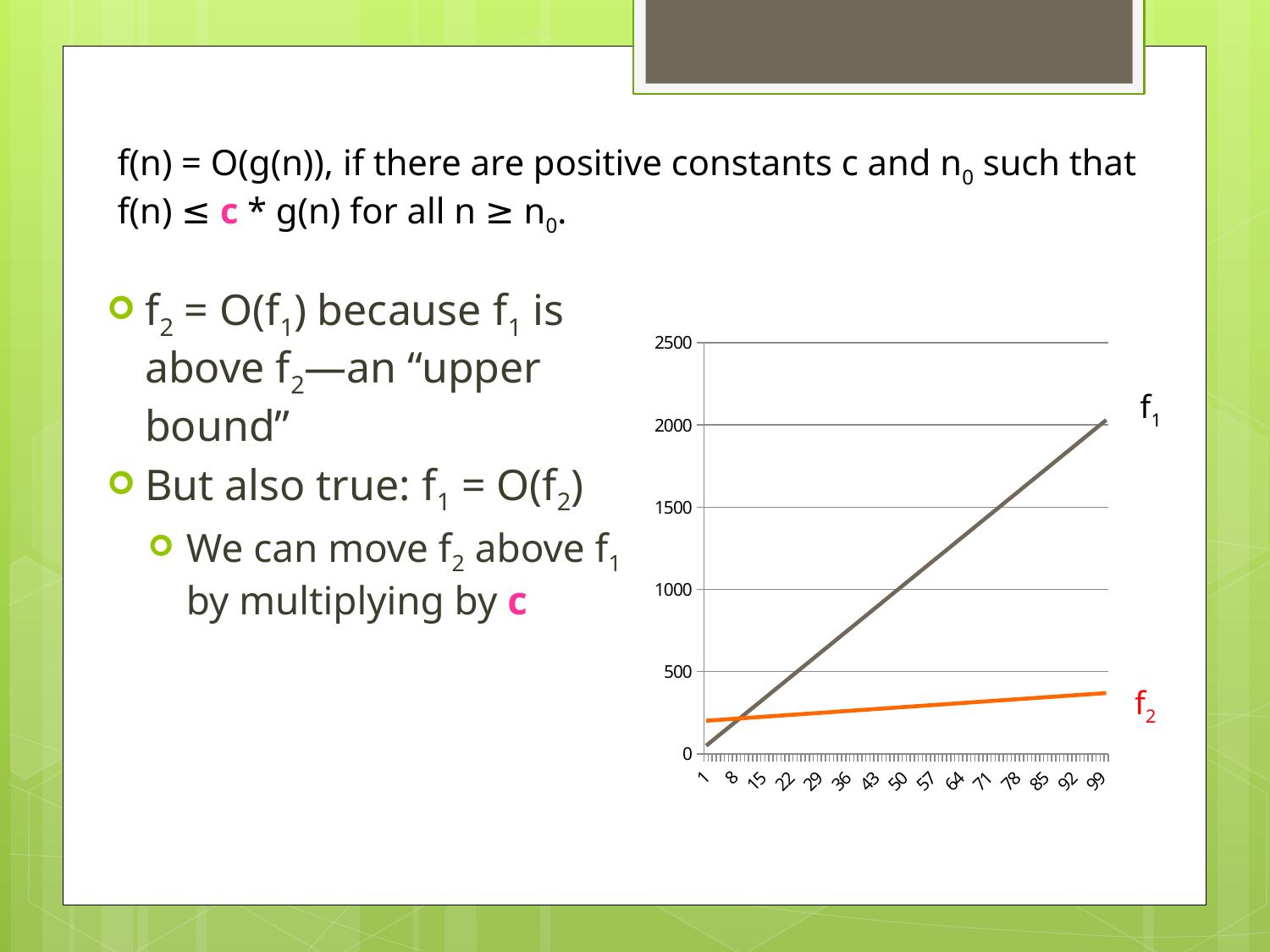
Is the value of f1 at x = 50 greater or less than 500? greater What are the labels of the two lines on the chart? f1 and f2 Which line has the lowest value at the right end of the x axis (x = 99)? f2 What kind of chart is shown on the slide? line chart At x = 99, which line is higher, f1 or f2? f1 Does the f1 line rise or fall as x increases? rise What is the highest value labelled on the y axis? 2500 Is the value of f1 at x = 99 greater or less than 1500? greater Which line reaches the highest value on the chart? f1 How many series are plotted on the chart? 2 Is the value of f2 at x = 99 greater or less than 500? less Does the f2 line rise or fall as x increases? rise